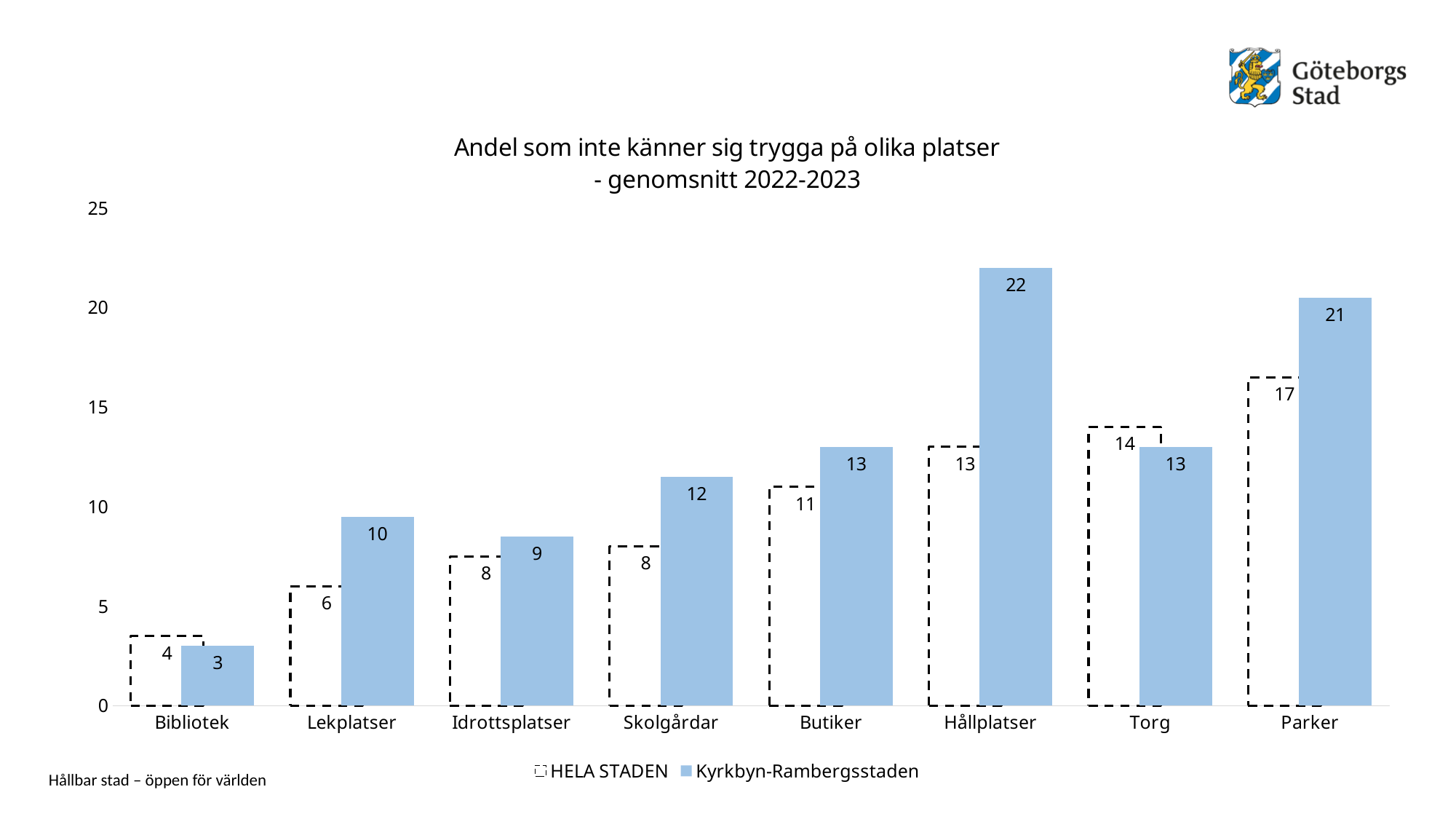
What is the difference between Kyrkbyn-Rambergsstaden and HELA STADEN at Hållplatser? 9 What is the value for Kyrkbyn-Rambergsstaden at Hållplatser? 22 Which category has the highest value for Kyrkbyn-Rambergsstaden? Hållplatser How many categories are shown on the x axis? 8 Which category has the lowest value for HELA STADEN? Bibliotek What kind of chart is shown on the slide? Bar chart What is the value for HELA STADEN at Parker? 17 How many series does the legend list? 2 What is the title of the chart? Andel som inte känner sig trygga på olika platser - genomsnitt 2022-2023 What is the value for Kyrkbyn-Rambergsstaden at Skolgårdar? 12 Which is larger at Torg: HELA STADEN or Kyrkbyn-Rambergsstaden? HELA STADEN Is the value for Kyrkbyn-Rambergsstaden at Parker greater or less than 20? greater